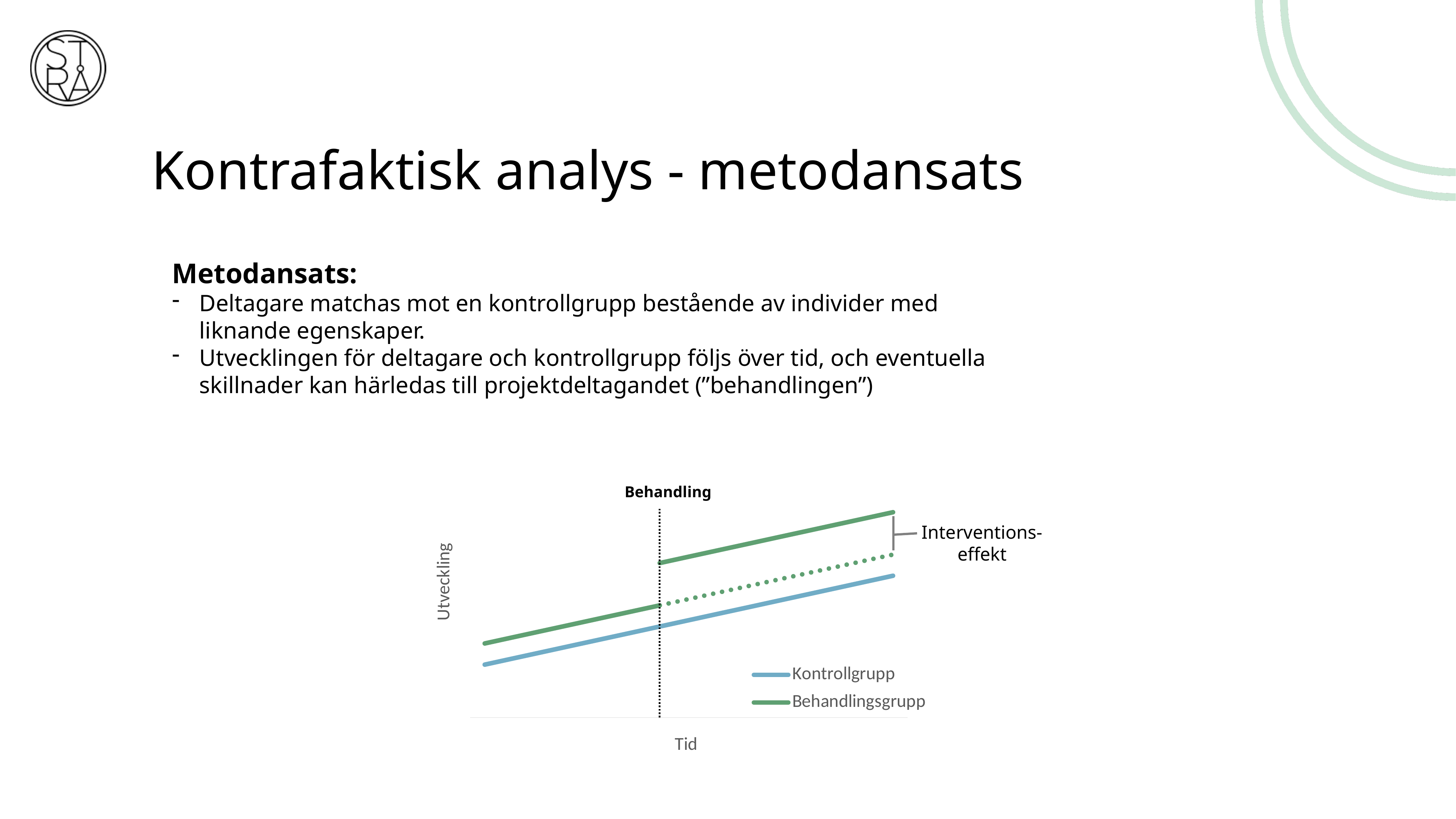
Which series is lower at the left end of the chart, Kontrollgrupp or Behandlingsgrupp? Kontrollgrupp Which two series are listed in the chart's legend? Kontrollgrupp and Behandlingsgrupp Which series is drawn in blue in the chart? Kontrollgrupp What is the label of the chart's x axis? Tid Do the values for Kontrollgrupp rise or fall along the x axis? Rise Do the values for Behandlingsgrupp rise or fall along the x axis? Rise What kind of chart is shown on the slide? Line chart Which series is higher at the right end of the chart, Kontrollgrupp or Behandlingsgrupp? Behandlingsgrupp How many series does the chart's legend list? 2